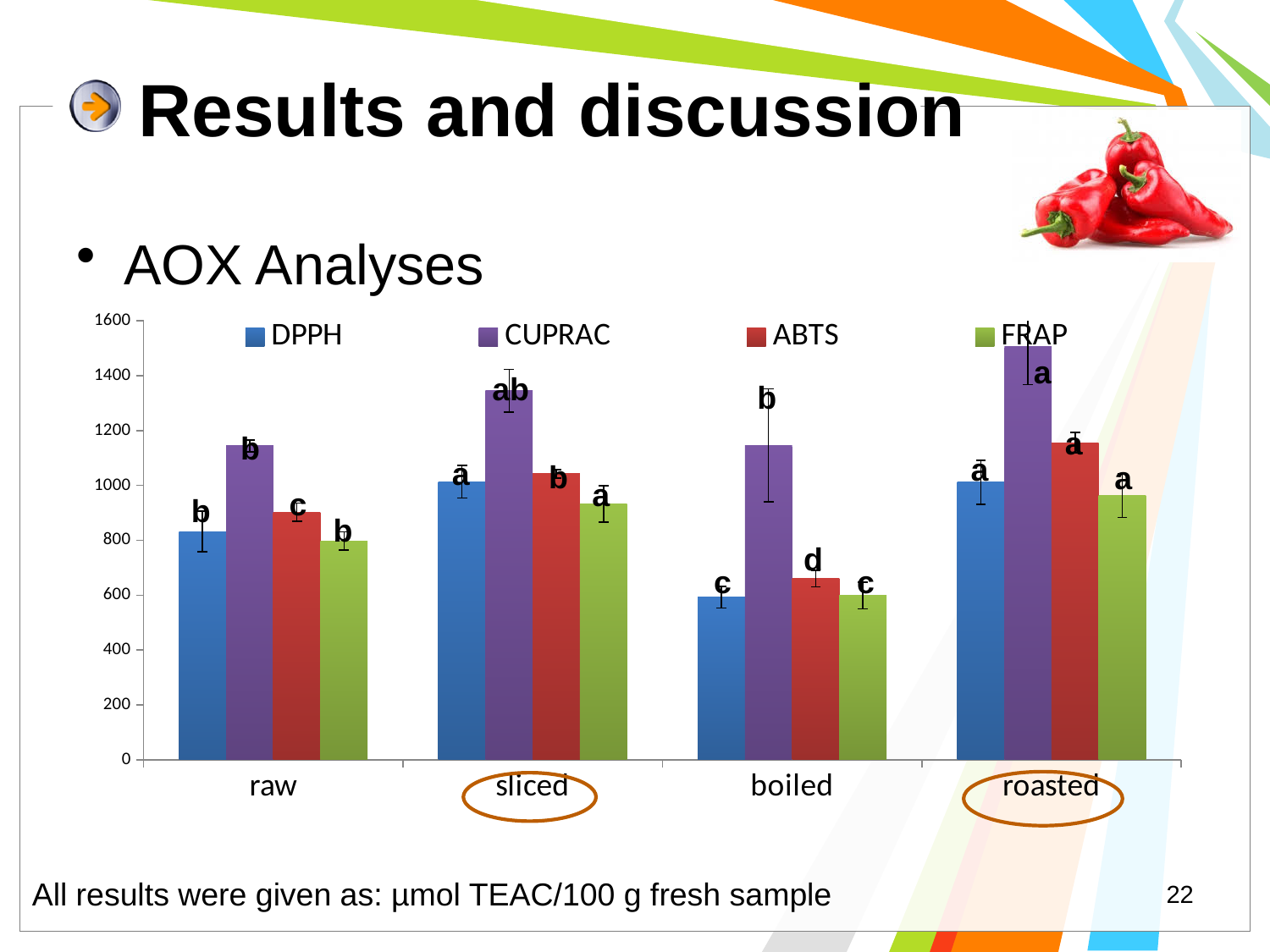
How many series does the chart legend list? 4 Is the CUPRAC value for sliced greater or less than 1200? greater What kind of chart is shown on the slide? bar chart Which is larger, the ABTS value for sliced or the ABTS value for boiled? sliced Which colour represents the FRAP series in the chart? green How many categories are shown on the x axis of the chart? 4 In which category is the CUPRAC bar the highest? roasted Which two x-axis categories are circled on the slide? sliced and roasted Which series has the highest bar in the roasted category? CUPRAC Is the DPPH value for boiled greater or less than 800? less In which category is the ABTS bar the lowest? boiled Is the CUPRAC value for roasted greater or less than 1400? greater